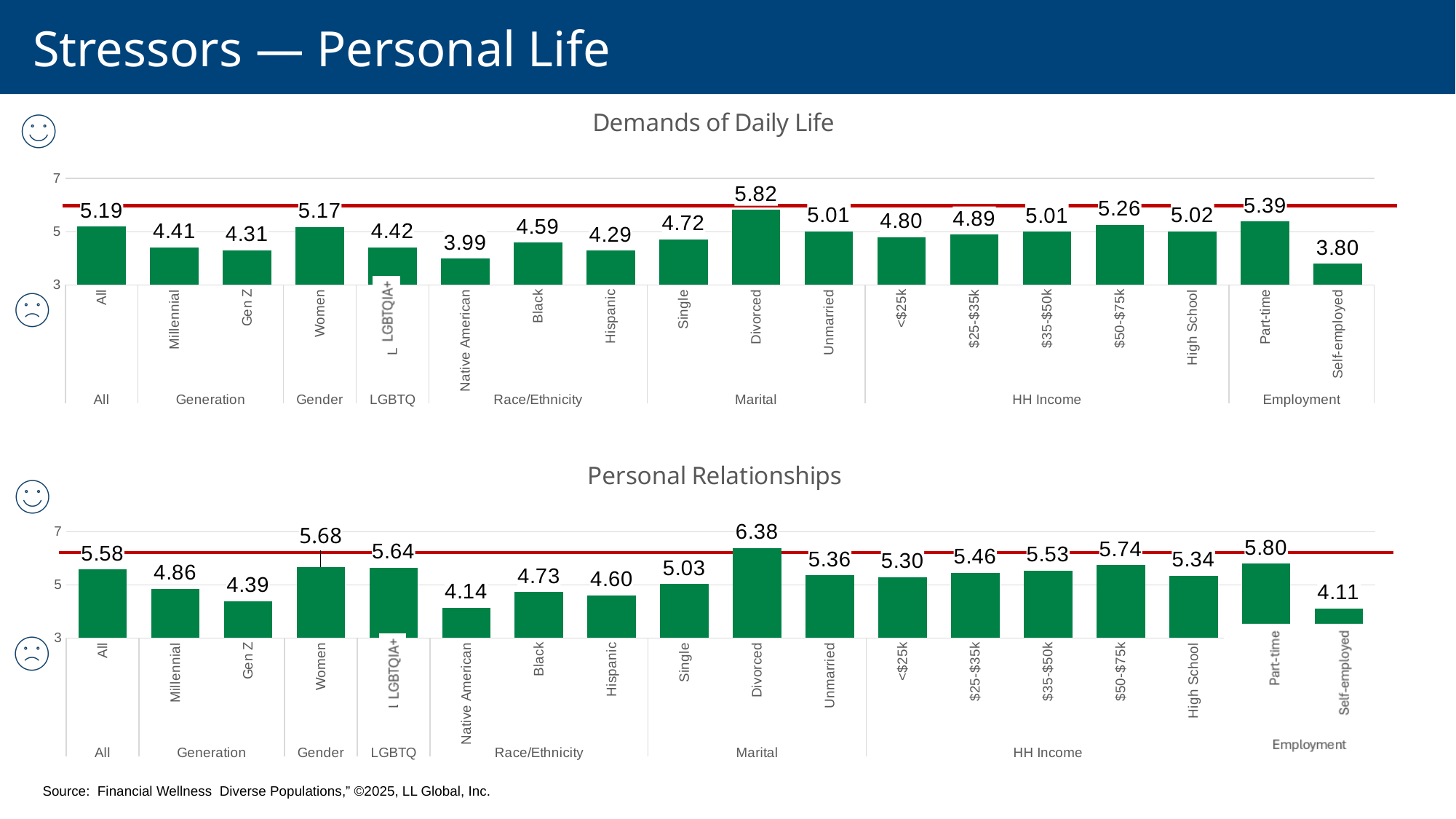
In the Demands of Daily Life chart, what is the value for Self-employed? 3.80 In the Personal Relationships chart, what is the value for Women? 5.68 In the Personal Relationships chart, what is the difference between the values for Divorced and Single? 1.35 In the Demands of Daily Life chart, which category has the highest value? Divorced In the Personal Relationships chart, which category has the highest value? Divorced In the Personal Relationships chart, which is larger, the value for Part-time or the value for High School? Part-time In the Demands of Daily Life chart, which category has the lowest value? Self-employed In the Demands of Daily Life chart, what is the difference between the values for Women and Millennial? 0.76 What kind of chart is the Demands of Daily Life chart? Bar chart In the Demands of Daily Life chart, is the value for Gen Z greater or less than 5? less In the Demands of Daily Life chart, what is the value for Divorced? 5.82 In the Personal Relationships chart, what is the value for Native American? 4.14